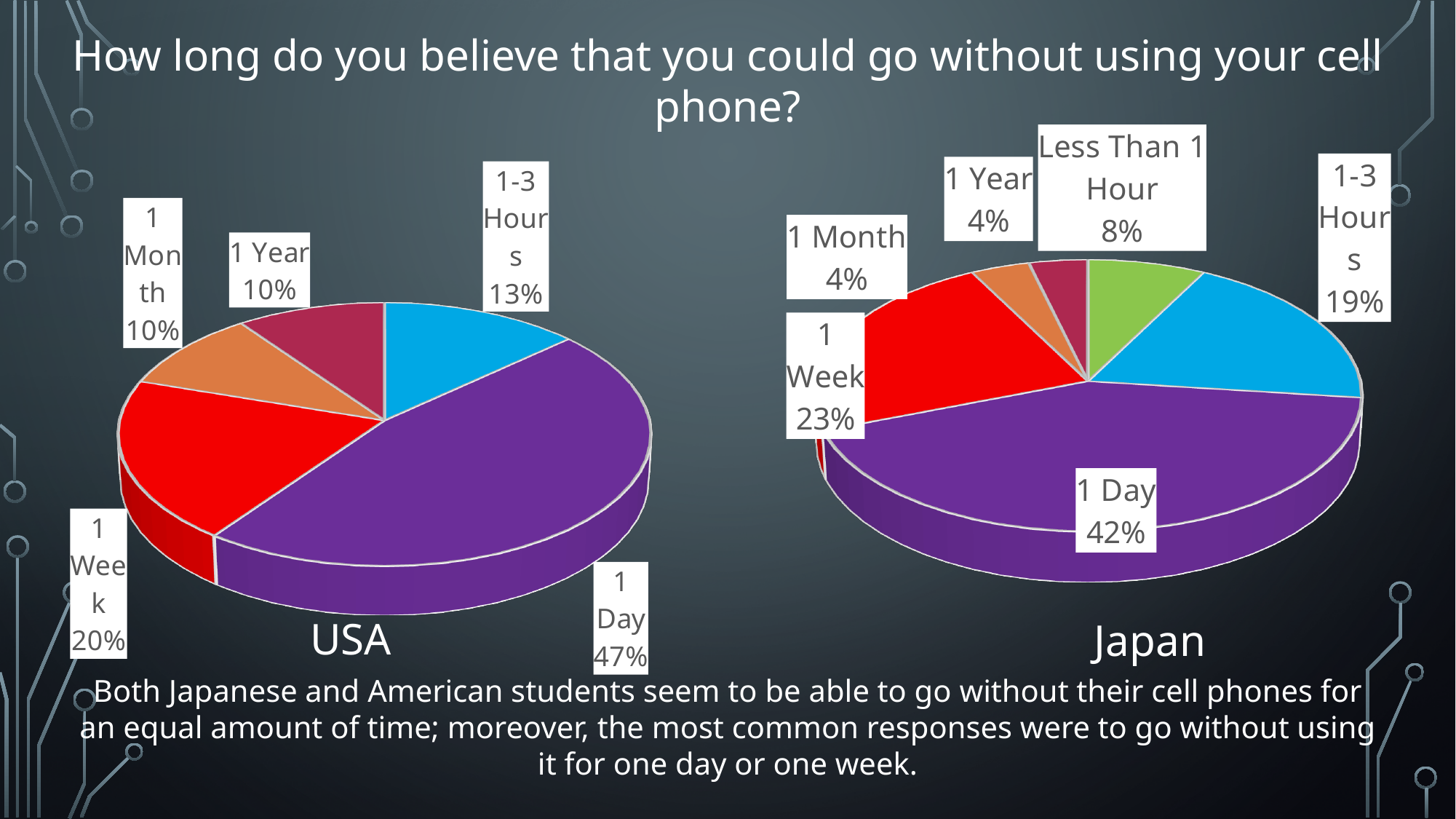
In the Japan pie chart, which category has the largest share? 1 Day In the Japan pie chart, what percentage of respondents said 1 Week? 23% In the USA pie chart, what is the difference between the 1 Day share and the 1 Week share? 27% Which is larger: the 1 Week share in the USA chart or the 1 Week share in the Japan chart? Japan How many slices does the Japan pie chart have? 6 In the USA pie chart, which category has the largest share? 1 Day In the USA pie chart, what percentage of respondents said 1 Day? 47% In the Japan pie chart, what percentage of respondents said Less Than 1 Hour? 8% In the Japan pie chart, which categories have the smallest share? 1 Month and 1 Year In the Japan pie chart, what is the difference between the 1-3 Hours share and the Less Than 1 Hour share? 11% How many slices does the USA pie chart have? 5 What type of chart is used for the USA data? Pie chart